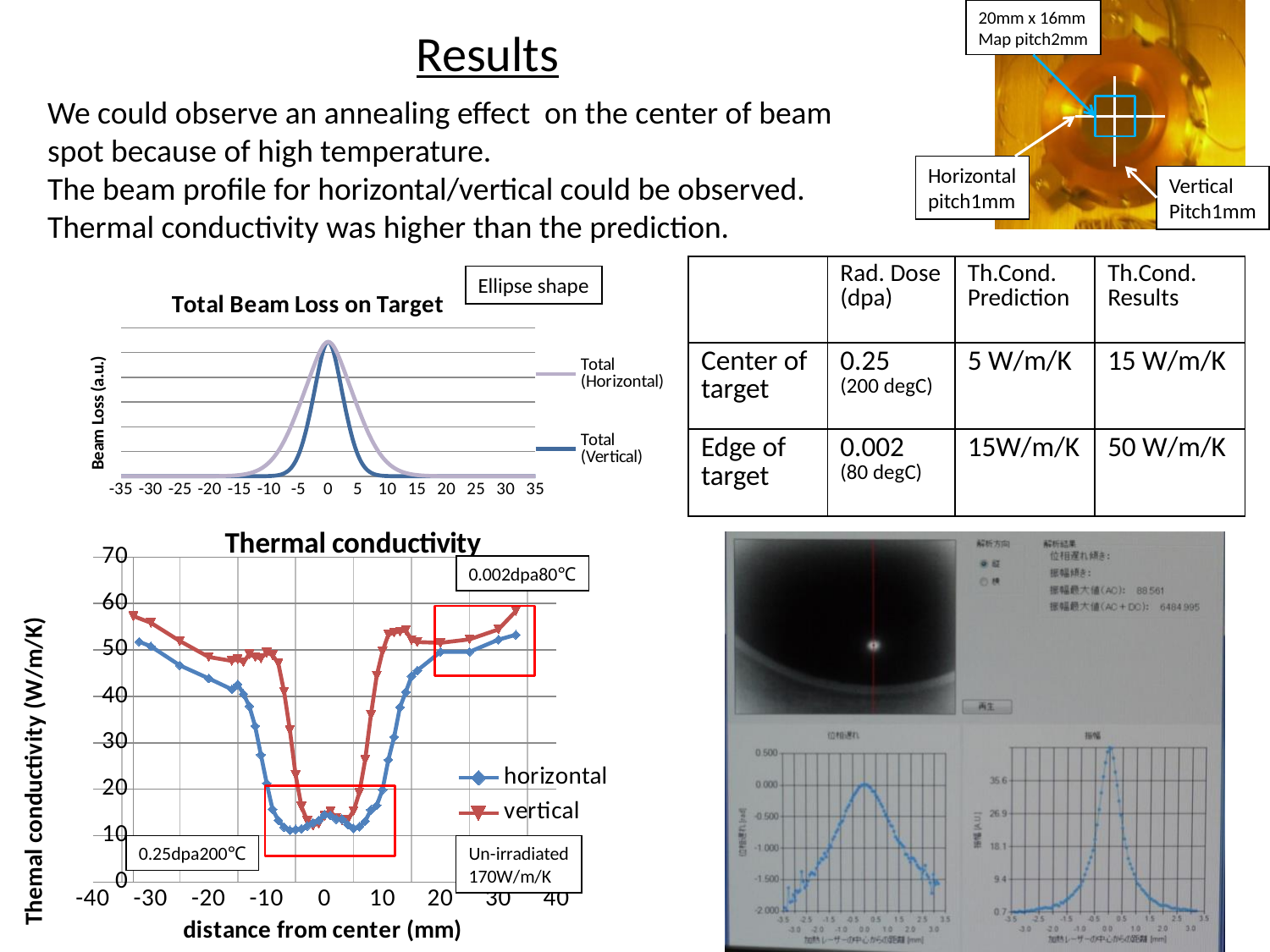
In the "Thermal conductivity" chart, does the horizontal series rise or fall as the distance goes from -30 mm to 0 mm? fall How many series does the legend of the "Thermal conductivity" chart list? 2 In the "Thermal conductivity" chart, is the horizontal series value at 0 mm greater or less than 20? less In the "Thermal conductivity" chart, is the vertical series value at -30 mm greater or less than 50? greater In the "Thermal conductivity" chart, is the vertical series value at -10 mm greater or less than 40? greater What is the x-axis label of the "Thermal conductivity" chart? distance from center (mm) How many series does the legend of the "Total Beam Loss on Target" chart list? 2 In the "Thermal conductivity" chart, which series has the higher value at -30 mm, horizontal or vertical? vertical In the "Total Beam Loss on Target" chart, which series has the wider curve, Total (Horizontal) or Total (Vertical)? Total (Horizontal) What kind of chart is the "Thermal conductivity" chart? line chart What are the two series named in the legend of the "Thermal conductivity" chart? horizontal and vertical